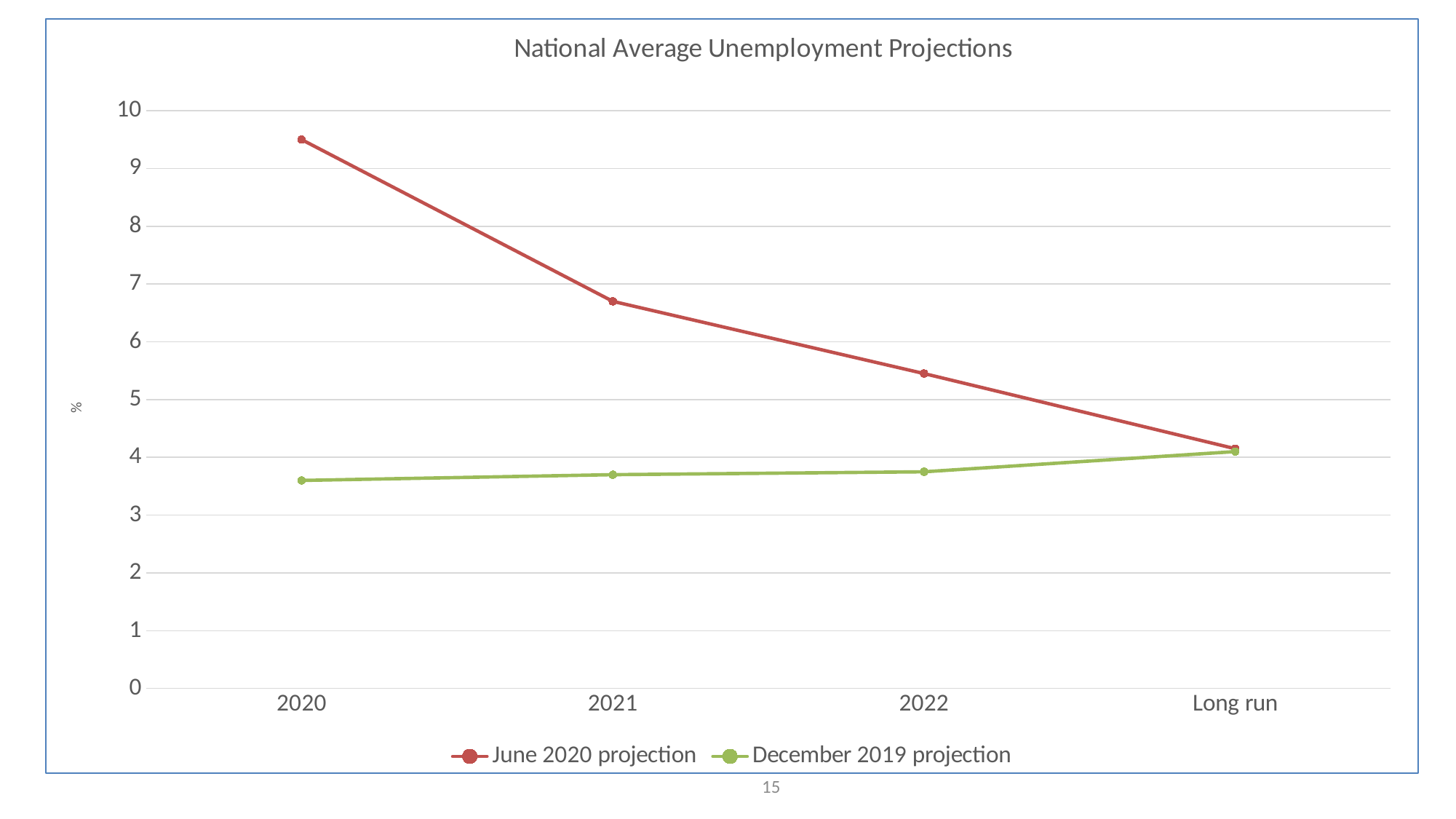
How many points are plotted along the x axis for each series? 4 At which x-axis category is the June 2020 projection highest? 2020 How many series does the legend list? 2 At which x-axis category is the June 2020 projection lowest? Long run Is the June 2020 projection value for 2021 greater or less than 7? less Does the June 2020 projection rise or fall from 2020 to Long run? fall Is the December 2019 projection value for 2020 greater or less than 4? less Is the June 2020 projection value for 2022 greater or less than 5? greater What is the title of the chart? National Average Unemployment Projections What type of chart is shown on the slide? line chart For 2020, which series has the larger value, June 2020 projection or December 2019 projection? June 2020 projection